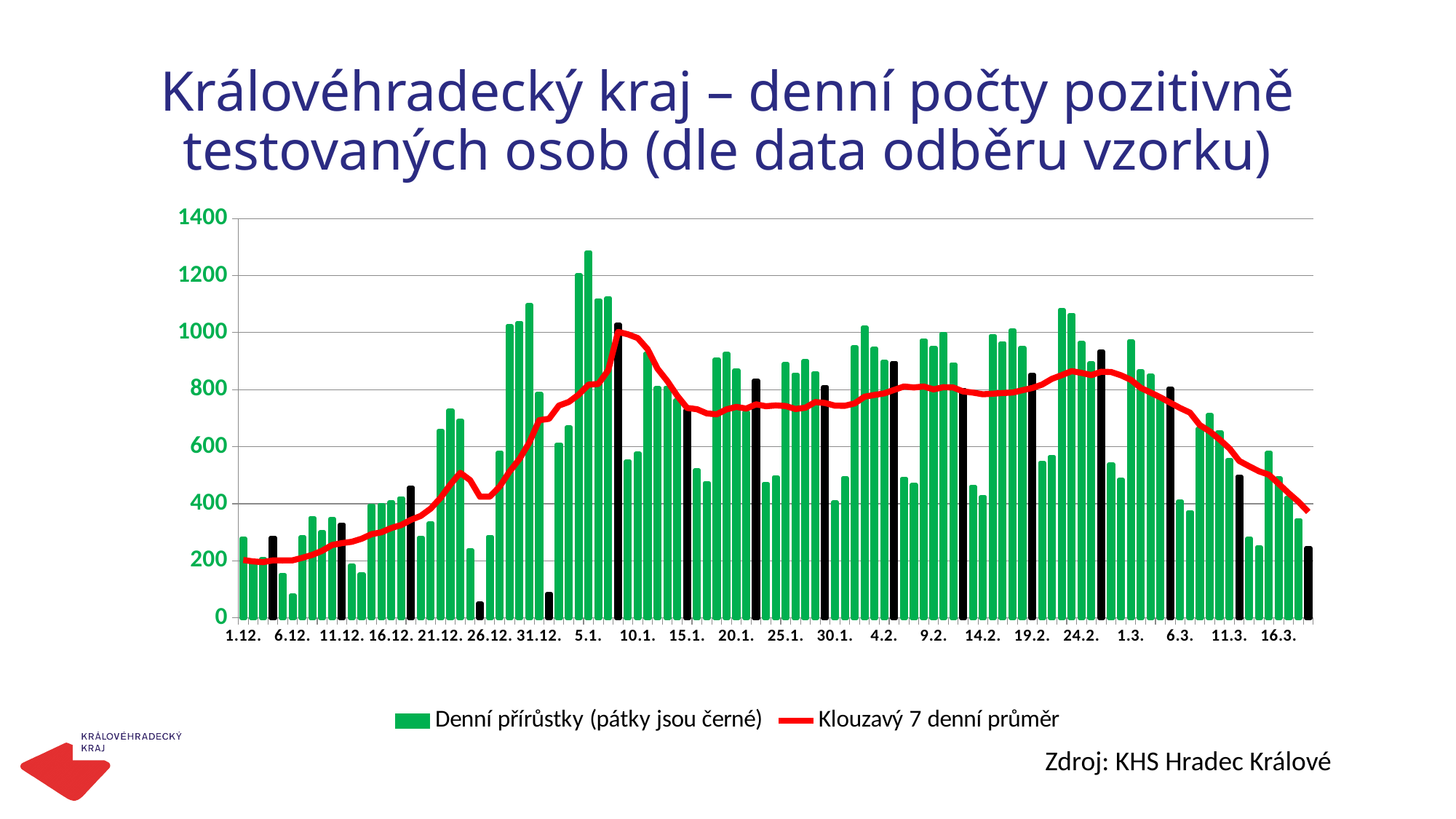
Does the 7-day moving average rise or fall between 1.12. and 5.1.? rise Is the daily value for 1.12. greater or less than 400? less What kind of chart is shown on the slide? A bar chart combined with a line Is the 7-day moving average higher at 10.1. or at 16.3.? 10.1. What does the red line in the chart represent, according to the legend? Klouzavý 7 denní průměr What is the highest value shown on the vertical axis? 1400 According to the legend, what colour are the bars for Fridays? Black How many series does the legend list? 2 Is the 7-day moving average at 10.1. greater or less than 800? greater Is the 7-day moving average at 16.3. greater or less than 600? less How many date labels are shown on the horizontal axis? 22 Does the 7-day moving average rise or fall between 1.3. and 16.3.? fall